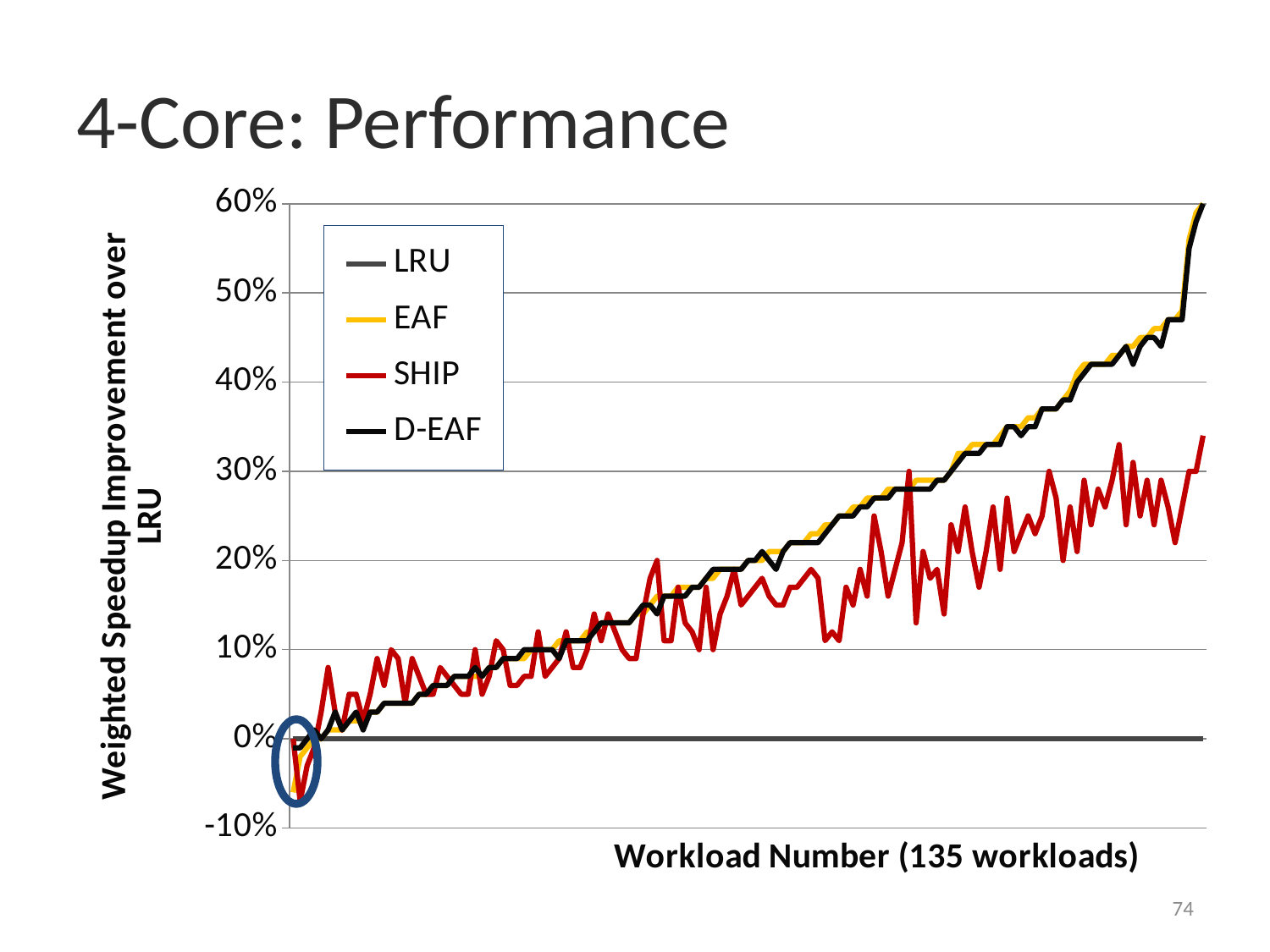
What is the label of the y axis? Weighted Speedup Improvement over LRU Is the value of SHIP at the rightmost workload greater or less than 40%? less Do the EAF values rise or fall as the workload number increases along the x axis? rise Which series stays flat at 0% across all workloads? LRU Do the D-EAF values rise or fall as the workload number increases along the x axis? rise Is the value of LRU at the rightmost workload greater or less than 10%? less What is the title of the slide containing the chart? 4-Core: Performance How many series does the legend list? 4 What kind of chart is shown on the slide? line chart How many workloads are plotted along the x axis? 135 Is the value of D-EAF at the rightmost workload greater or less than 50%? greater At the rightmost workload, which series has the larger value, EAF or SHIP? EAF